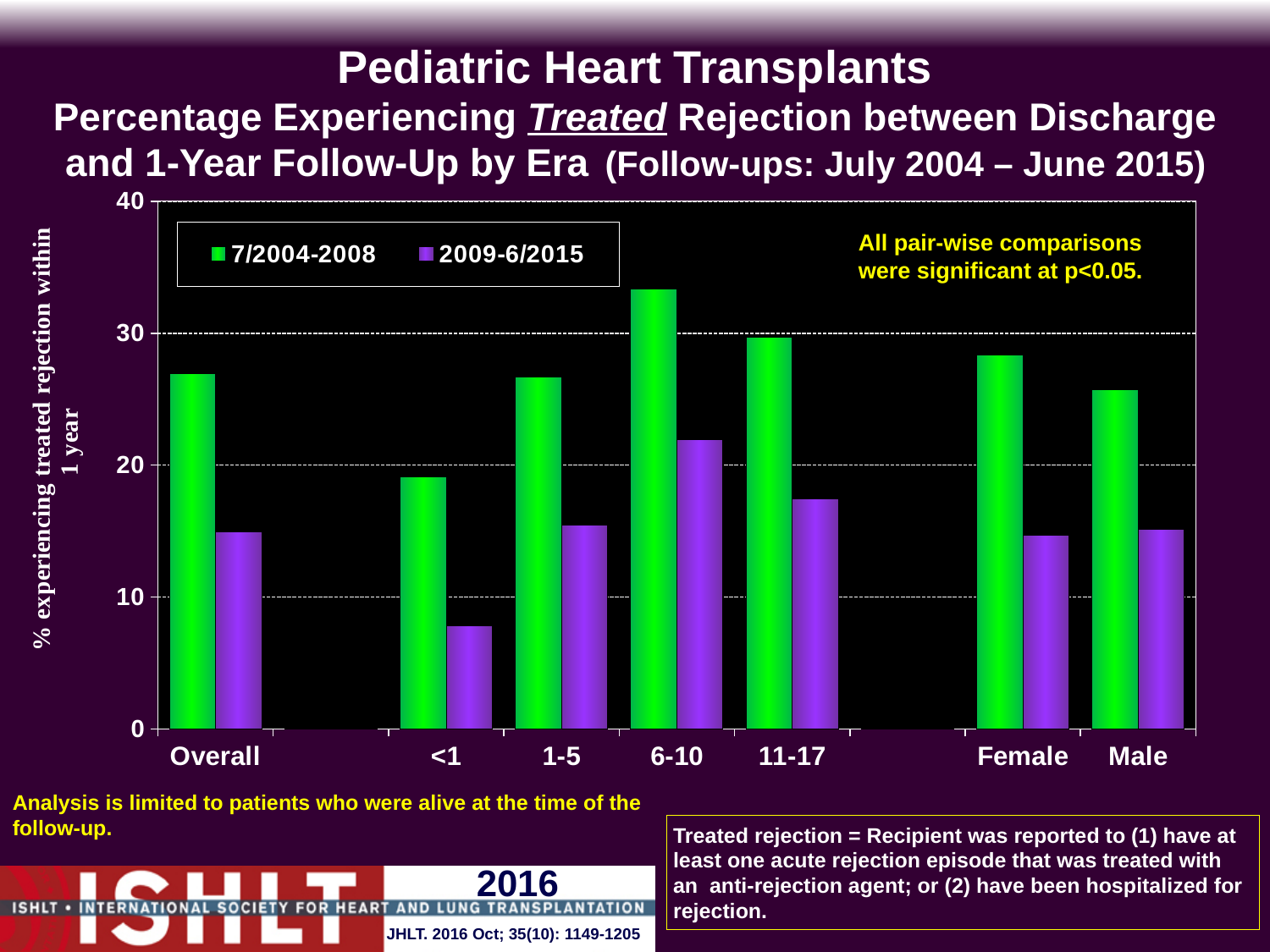
Which colour represents the 2009-6/2015 series? purple Which category has the lowest value for the 2009-6/2015 series? <1 Is the value for 6-10 in the 2009-6/2015 series greater or less than 20? greater How many series does the legend list? 2 Which category has the lowest value for the 7/2004-2008 series? <1 Which category has the highest value for the 7/2004-2008 series? 6-10 Is the value for <1 in the 2009-6/2015 series greater or less than 10? less For the Overall category, which series has the larger value, 7/2004-2008 or 2009-6/2015? 7/2004-2008 Is the value for 6-10 in the 7/2004-2008 series greater or less than 30? greater What kind of chart is shown on the slide? bar chart What is the label of the y axis? % experiencing treated rejection within 1 year How many categories are shown along the x axis? 7